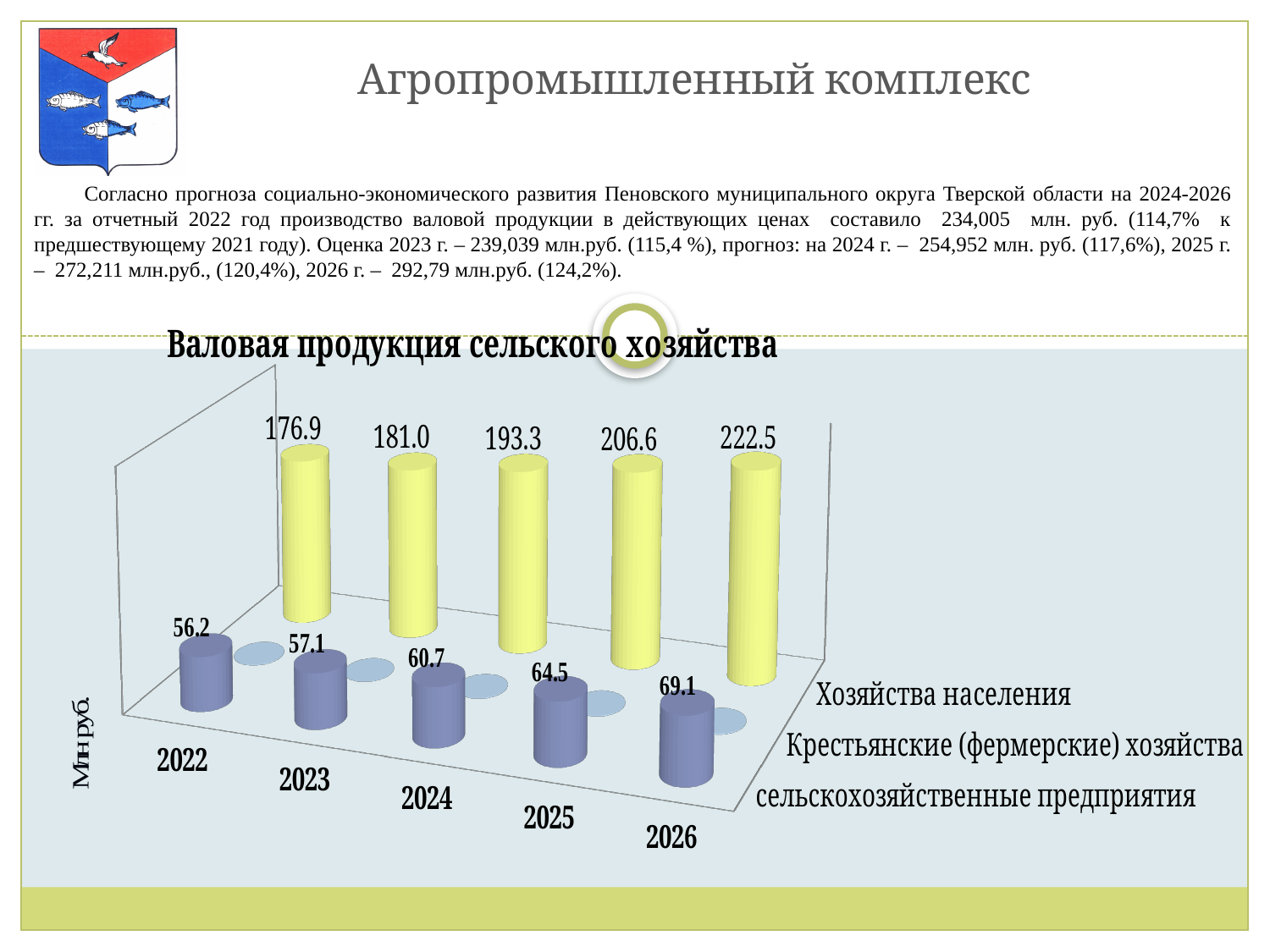
What is the value for сельскохозяйственные предприятия in 2025? 64.5 What is the title of the chart? Валовая продукция сельского хозяйства What is the value for Хозяйства населения in 2026? 222.5 What is the difference between the сельскохозяйственные предприятия values for 2026 and 2022? 12.9 How many years are shown on the chart? 5 What is the value for Хозяйства населения in 2024? 193.3 What is the value for сельскохозяйственные предприятия in 2022? 56.2 Do the values for Хозяйства населения rise or fall from 2022 to 2026? rise In which year is the value for сельскохозяйственные предприятия lowest? 2022 In which year is the value for Хозяйства населения highest? 2026 Which is larger in 2023: Хозяйства населения or сельскохозяйственные предприятия? Хозяйства населения What is the difference between the Хозяйства населения values for 2026 and 2022? 45.6